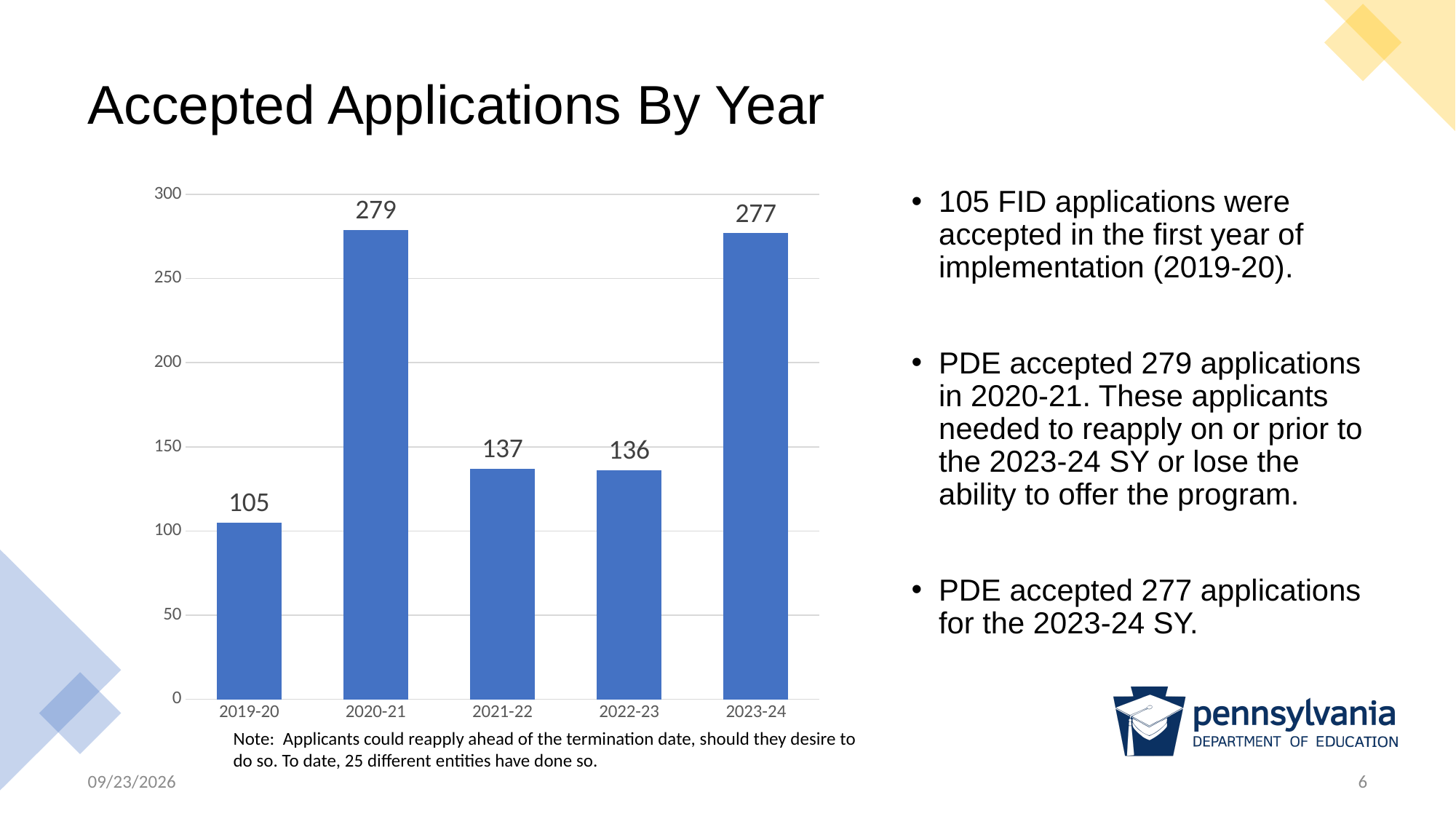
What is the value for 2022-23? 136 How many years are shown on the x axis? 5 What is the difference between the values for 2020-21 and 2019-20? 174 Which is larger, the value for 2021-22 or the value for 2019-20? 2021-22 Is the value for 2023-24 greater or less than 250? greater What is the title of the slide containing the chart? Accepted Applications By Year What is the value for 2021-22? 137 What is the difference between the values for 2020-21 and 2023-24? 2 Which year has the highest value? 2020-21 Which year has the lowest value? 2019-20 What kind of chart is shown on the slide? bar chart What is the value for 2019-20? 105